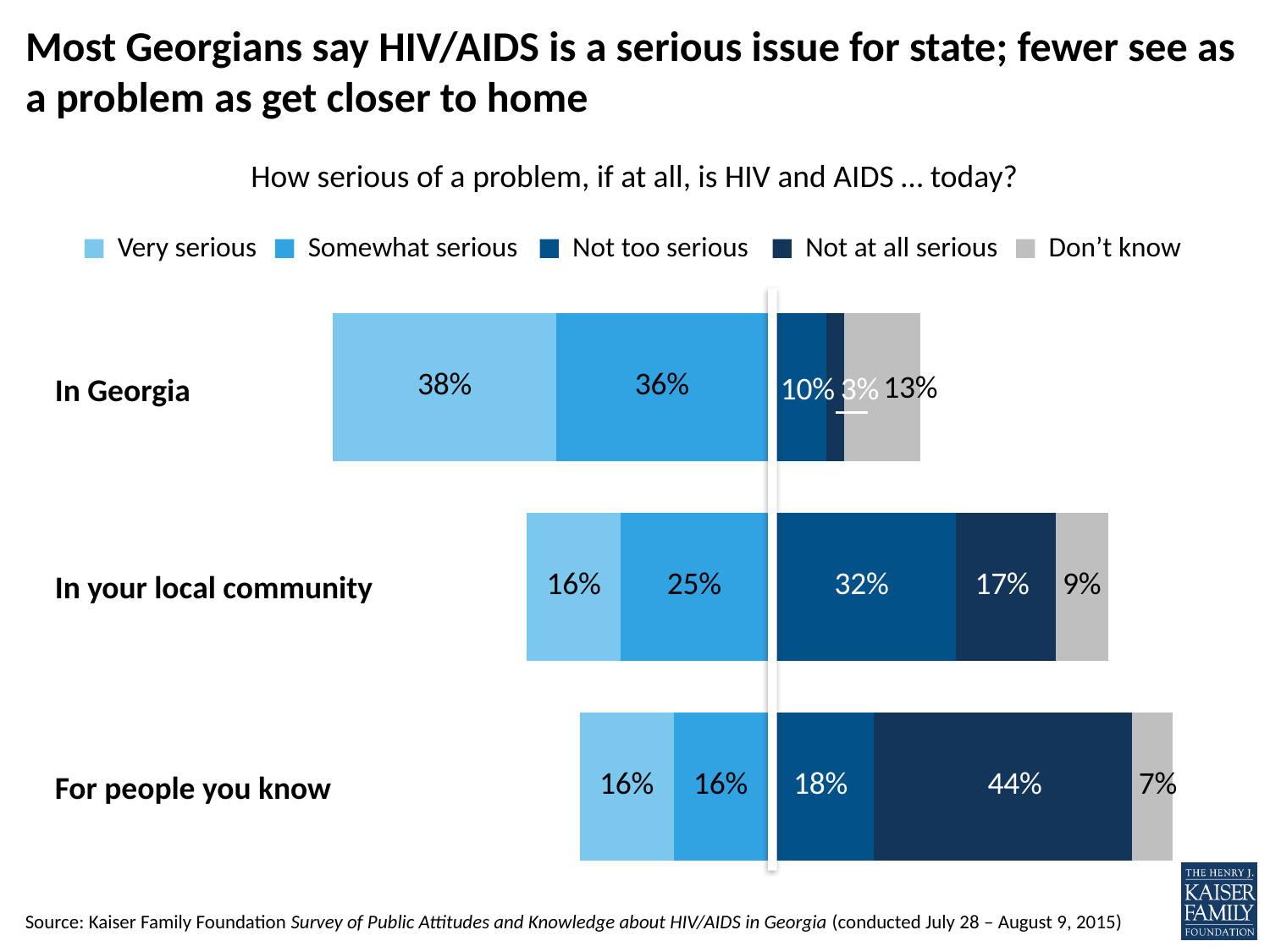
Which category has the lowest 'Don't know' percentage? For people you know What percentage say HIV/AIDS is not at all serious for people you know? 44% What is the difference between the 'Somewhat serious' percentages for In Georgia and In your local community? 11 percentage points How many series does the legend list? 5 Which category has the highest 'Very serious' percentage? In Georgia What is the combined percentage of 'Very serious' and 'Somewhat serious' for In Georgia? 74% What percentage say HIV/AIDS is a very serious problem in Georgia? 38% What kind of chart is shown on the slide? Stacked bar chart What percentage answered 'Don't know' for In Georgia? 13% Which is larger: the 'Not at all serious' share for In your local community or for For people you know? For people you know What percentage say HIV/AIDS is not too serious in your local community? 32% How many categories (bars) are shown in the chart? 3